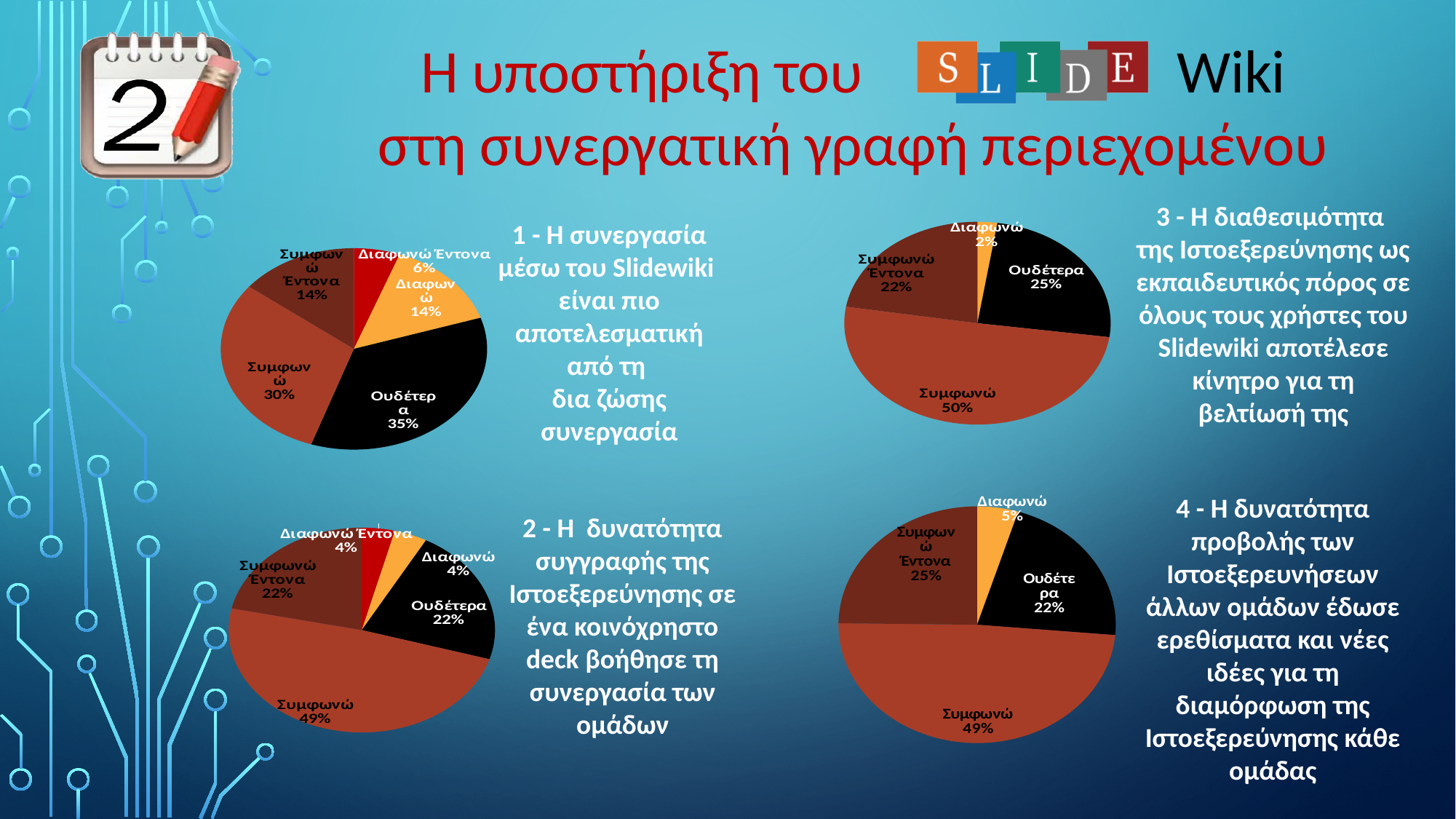
In the bottom-right pie chart, what percentage is shown for Συμφωνώ Έντονα? 25% How many slices does the top-right pie chart have? 4 In the top-left pie chart, what percentage is shown for Ουδέτερα? 35% In the bottom-left pie chart, which category has the largest share? Συμφωνώ In the top-left pie chart, what is the difference between the Ουδέτερα and Συμφωνώ shares? 5% In the top-right pie chart, which is larger, Ουδέτερα or Συμφωνώ Έντονα? Ουδέτερα In the top-left pie chart, which category has the smallest share? Διαφωνώ Έντονα In the bottom-right pie chart, what is the difference between the Συμφωνώ and Ουδέτερα shares? 27% What type of chart is the top-left chart? Pie chart In the bottom-left pie chart, what percentage is shown for Συμφωνώ? 49% How many slices does the bottom-left pie chart have? 5 In the top-right pie chart, what percentage is shown for Διαφωνώ? 2%